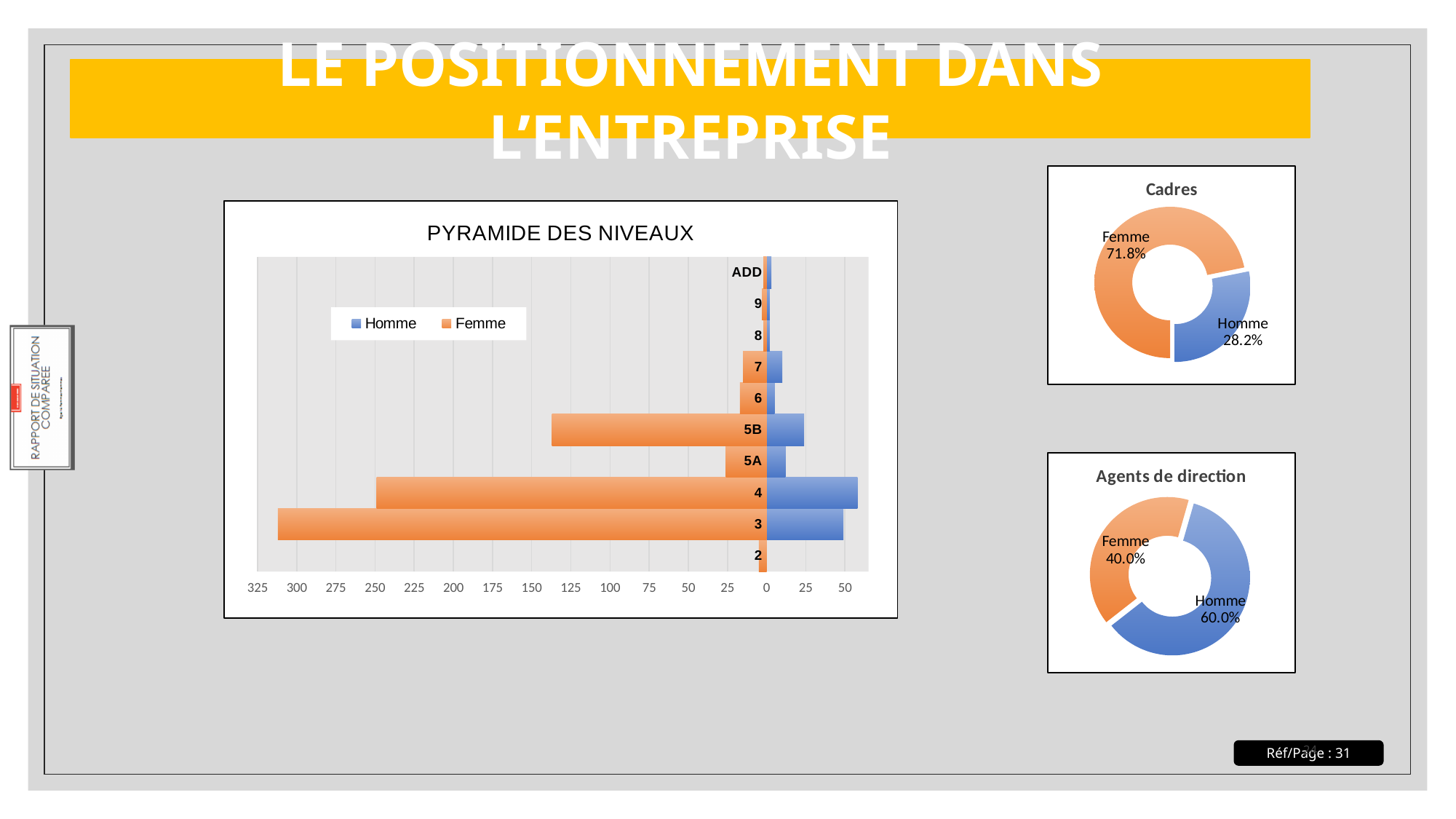
In the PYRAMIDE DES NIVEAUX chart, how many levels are listed on the vertical axis? 10 In the Cadres chart, which group has the larger share, Femme or Homme? Femme In the Cadres chart, what share is labelled for Homme? 28.2% In the Agents de direction chart, what share is labelled for Femme? 40.0% In the PYRAMIDE DES NIVEAUX chart, is the Femme value for level 3 greater or less than 300? greater In the PYRAMIDE DES NIVEAUX chart, how many series does the legend list? 2 In the PYRAMIDE DES NIVEAUX chart, which level has the longest Femme bar? 3 In the PYRAMIDE DES NIVEAUX chart, is the Femme value for level 5B greater or less than 150? less What kind of chart is the Cadres chart? Doughnut chart In the Agents de direction chart, what share is labelled for Homme? 60.0% In the Cadres chart, what share is labelled for Femme? 71.8% In the Agents de direction chart, what is the difference between the Homme and Femme shares? 20.0%